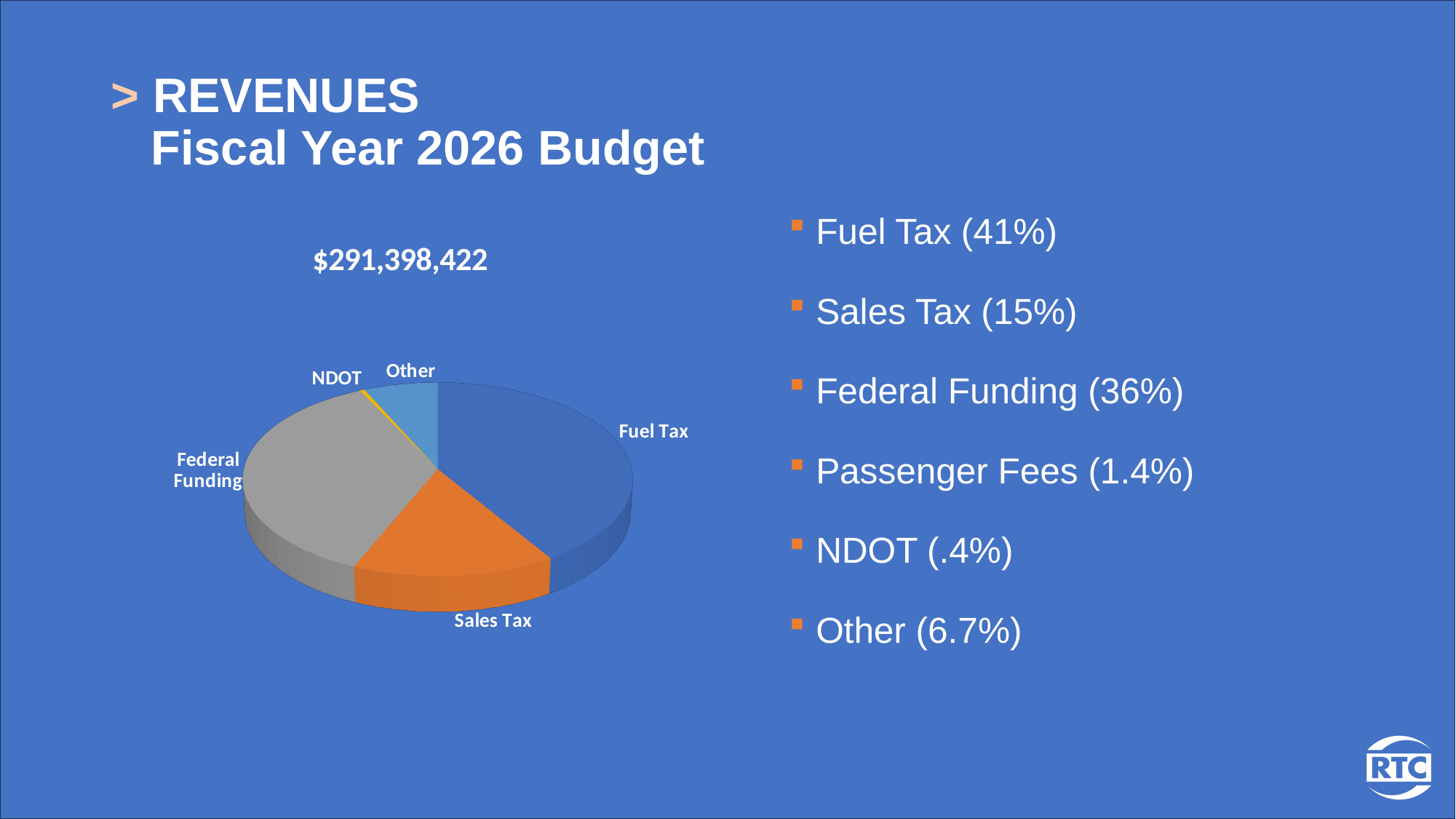
How many slices are labeled on the pie chart? 5 Which category has the largest slice of the pie chart? Fuel Tax How many percentage points larger is the Fuel Tax share than the Federal Funding share? 5 Which slice is larger, Other or NDOT? Other What share of revenues does Fuel Tax represent? 41% Which labeled category has the smallest slice of the pie chart? NDOT What kind of chart is shown on the slide? pie chart What share of revenues does Federal Funding represent? 36% What share of revenues does Sales Tax represent? 15% What is the title shown above the pie chart? $291,398,422 Which slice is larger, Federal Funding or Sales Tax? Federal Funding